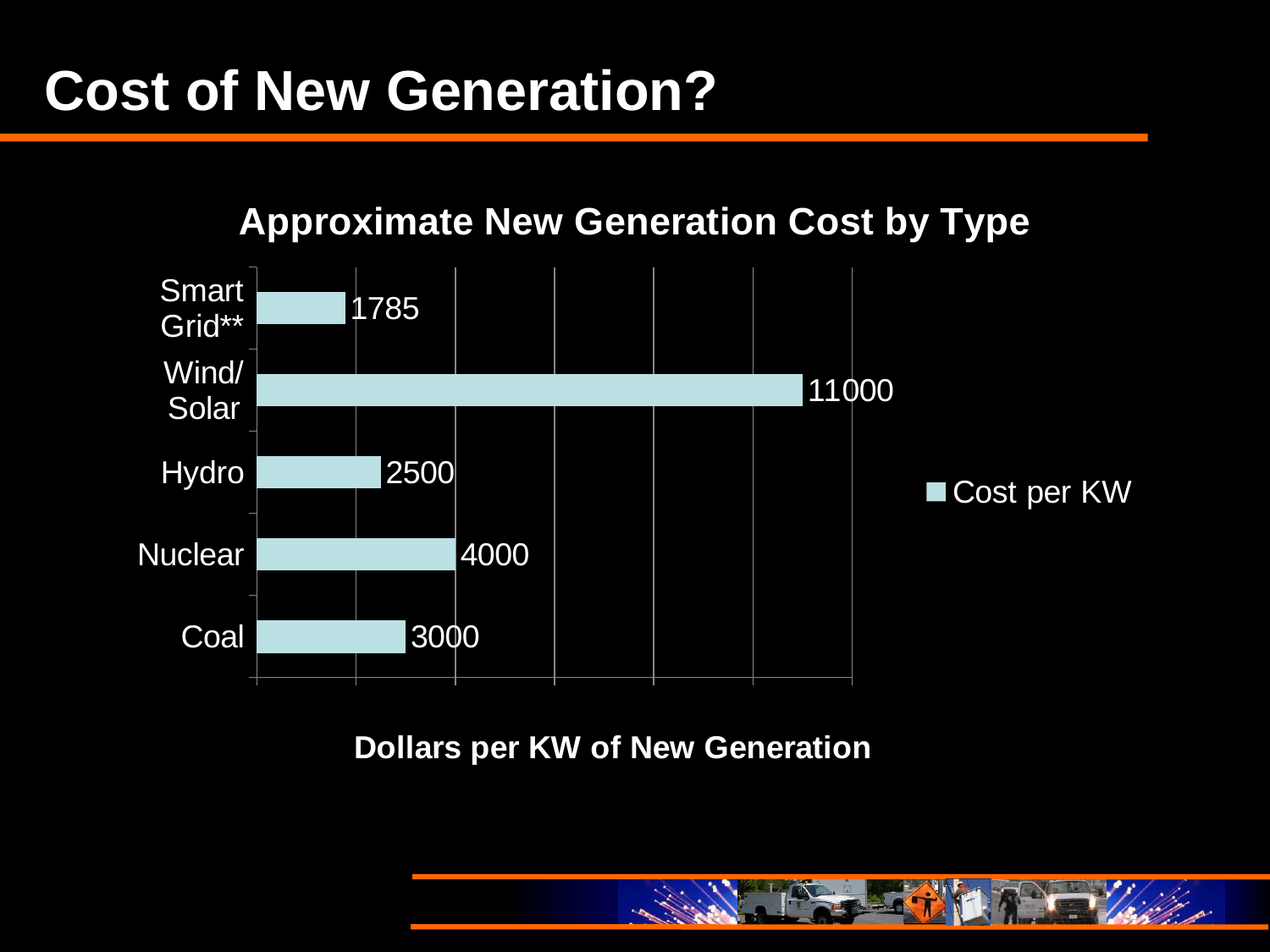
What is the title of the chart? Approximate New Generation Cost by Type What is the cost per KW for Wind/Solar? 11000 What is the cost per KW for Smart Grid**? 1785 How many generation types are shown in the chart? 5 How many series does the legend list? 1 What is the difference in cost per KW between Wind/Solar and Hydro? 8500 What kind of chart is shown on the slide? Bar chart Which has a higher cost per KW, Hydro or Coal? Coal What is the difference in cost per KW between Nuclear and Coal? 1000 Which generation type has the highest cost per KW? Wind/Solar What is the cost per KW for Nuclear? 4000 Which generation type has the lowest cost per KW? Smart Grid**